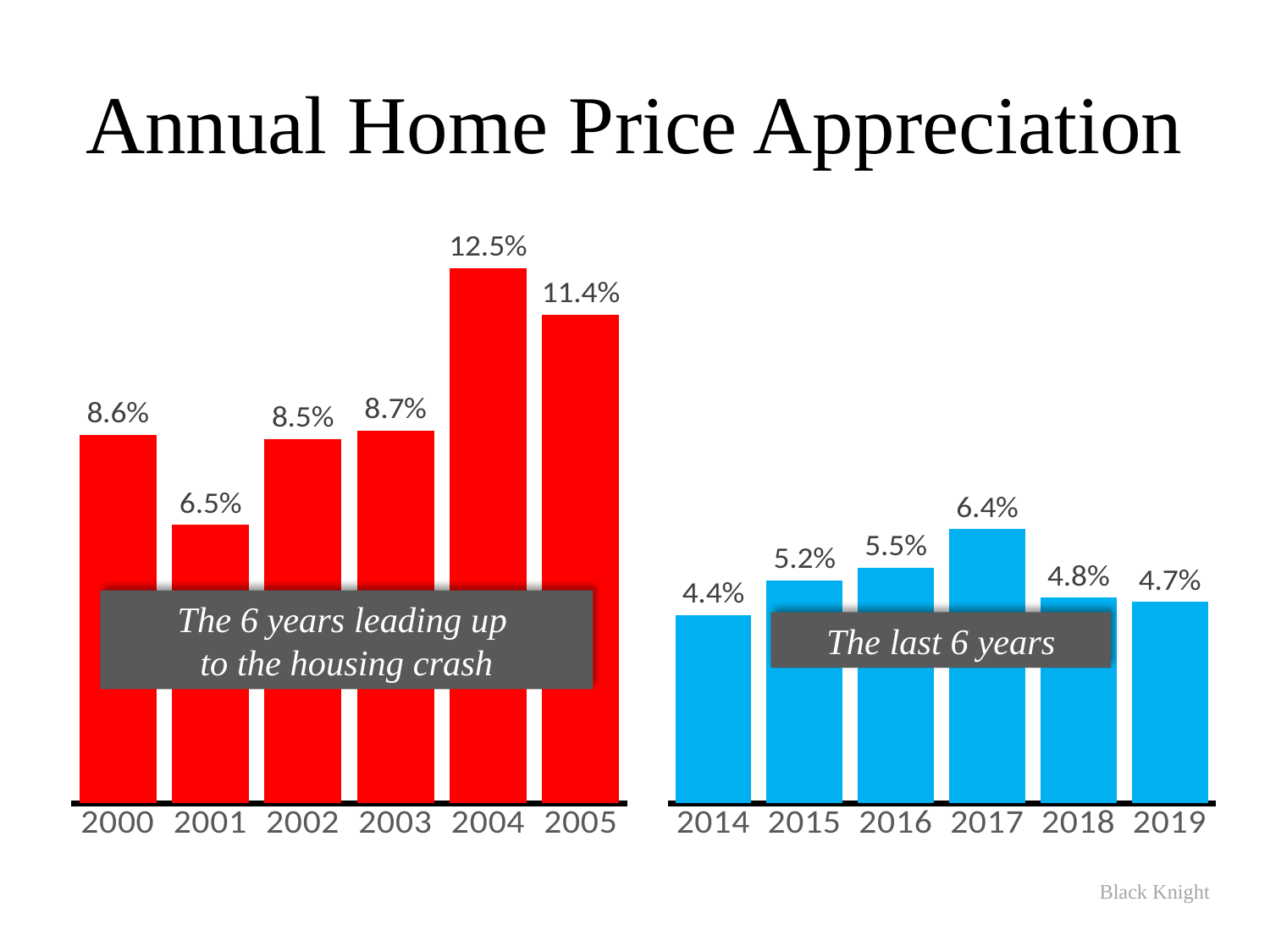
In the right chart (2014–2019), what is the difference between the values for 2017 and 2014? 2.0% What kind of chart is used on this slide? Bar chart In the right chart (2014–2019), which is larger, the value for 2016 or the value for 2018? 2016 In the right chart (2014–2019), what is the value for 2017? 6.4% In the left chart (2000–2005), which is larger, the value for 2000 or the value for 2001? 2000 In the right chart (2014–2019), do the values rise or fall from 2014 to 2017? Rise In the left chart (2000–2005), what is the value for 2004? 12.5% How many years are shown in the left chart (2000–2005)? 6 In the left chart (2000–2005), which year has the lowest value? 2001 In the left chart (2000–2005), what is the difference between the values for 2004 and 2005? 1.1% What colour are the bars in the right chart (2014–2019)? Blue In the right chart (2014–2019), which year has the highest value? 2017